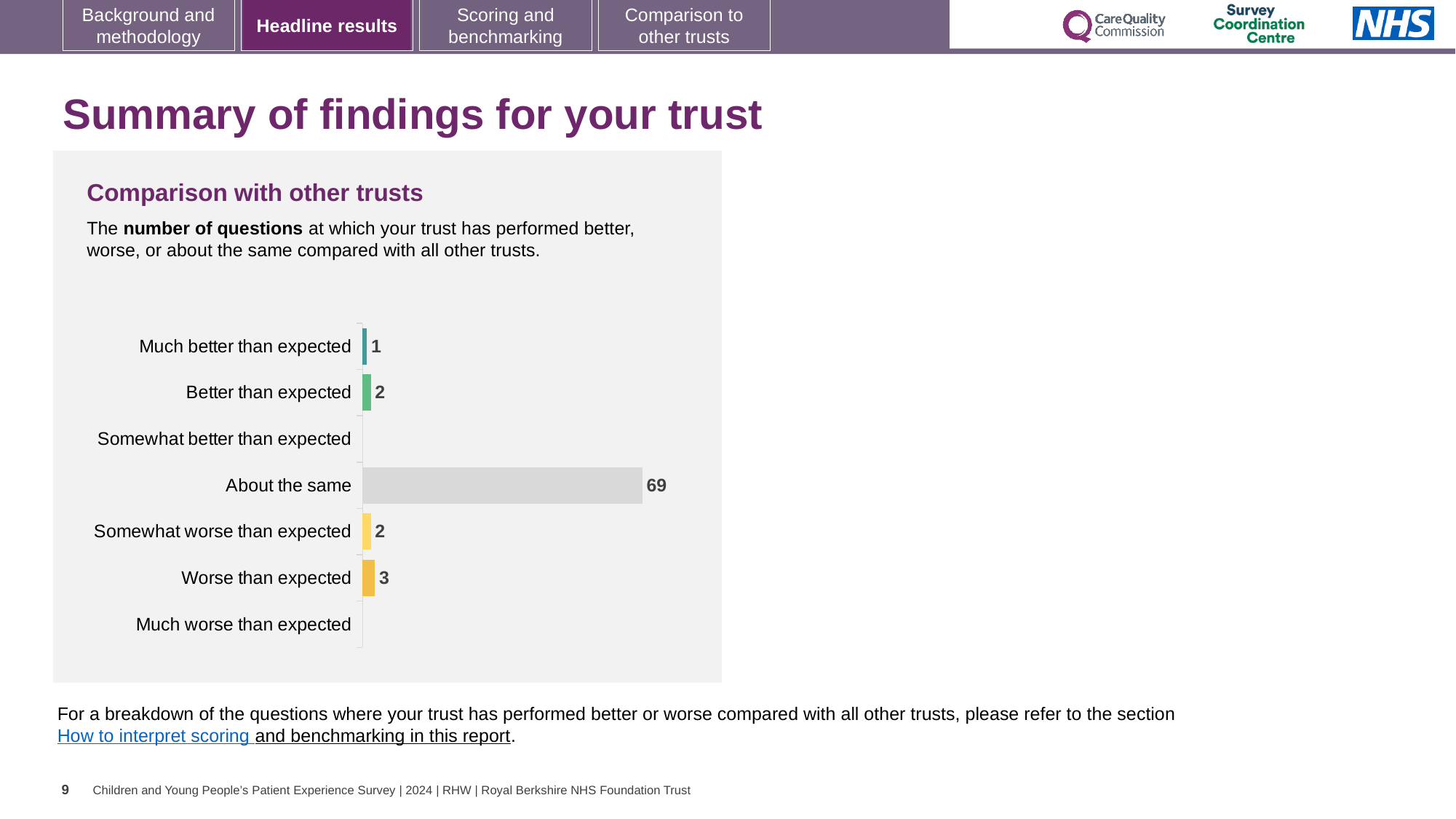
Which category has the highest number of questions? About the same What is the value for 'Much better than expected'? 1 What is the difference between 'About the same' and 'Worse than expected'? 66 What is the total number of questions across 'Much better than expected' and 'Better than expected'? 3 What is the title of the chart section on the slide? Comparison with other trusts How many categories are listed on the chart's axis? 7 What is the value for 'Somewhat worse than expected'? 2 What is the value for 'Worse than expected'? 3 What kind of chart is shown on the slide? Bar chart How many questions are in the 'About the same' category? 69 Which is larger, 'Worse than expected' or 'Better than expected'? Worse than expected What colour is the 'About the same' bar? Grey